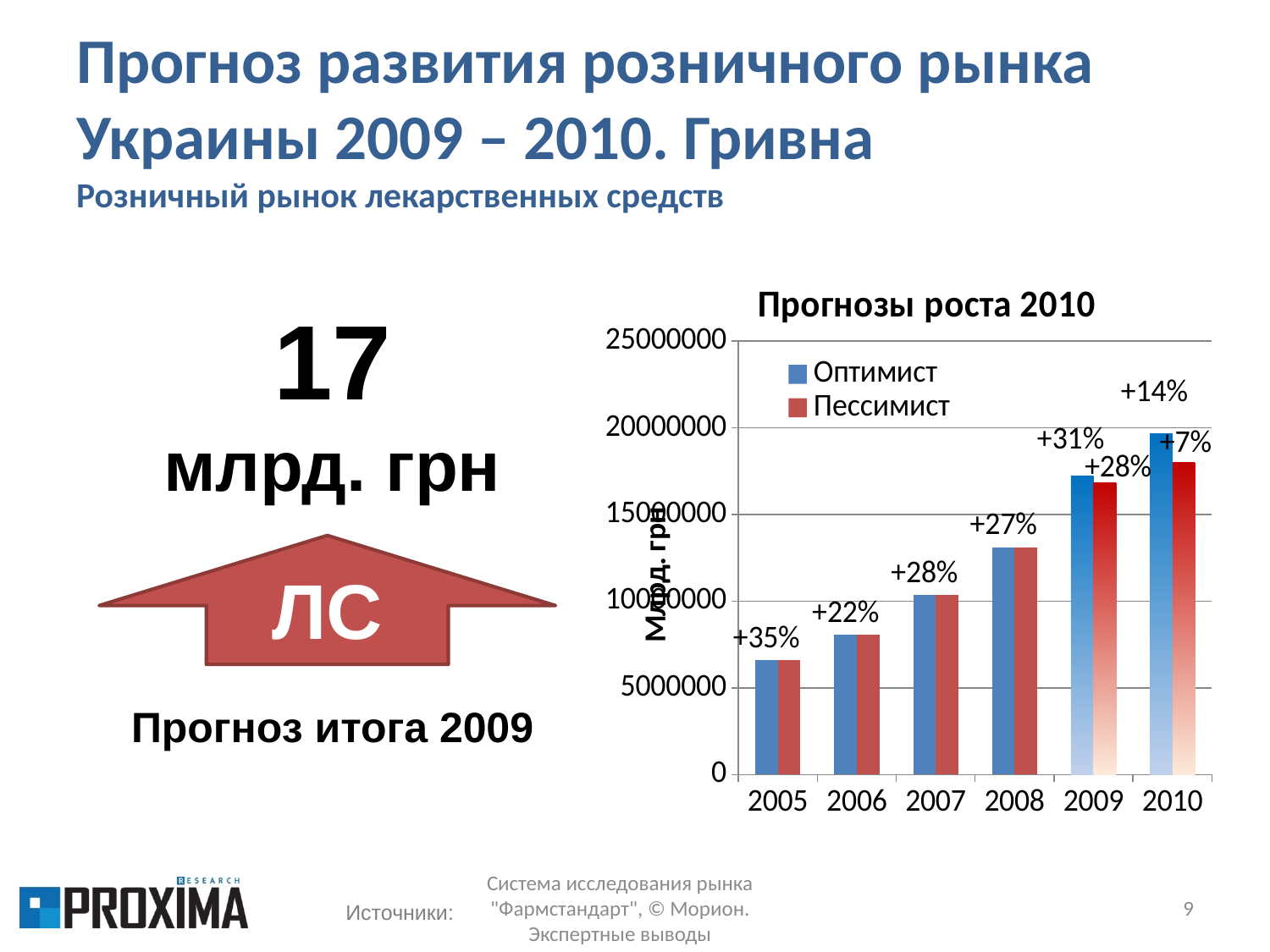
Is the value for 2006 greater or less than 10000000? less What growth percentage is labelled for the Оптимист series in 2009? +31% Do the bar values rise or fall from 2005 to 2010? rise What growth percentage is labelled for the Пессимист series in 2010? +7% What kind of chart is shown on the slide? Bar chart What is the title of the chart? Прогнозы роста 2010 Which two series are listed in the chart legend? Оптимист and Пессимист What growth percentage is labelled for the Оптимист series in 2010? +14% How many series does the chart legend list? 2 How many years are shown on the x axis of the chart? 6 Is the Оптимист value for 2009 greater or less than 15000000? greater What growth percentage is labelled above the bars for 2005? +35%